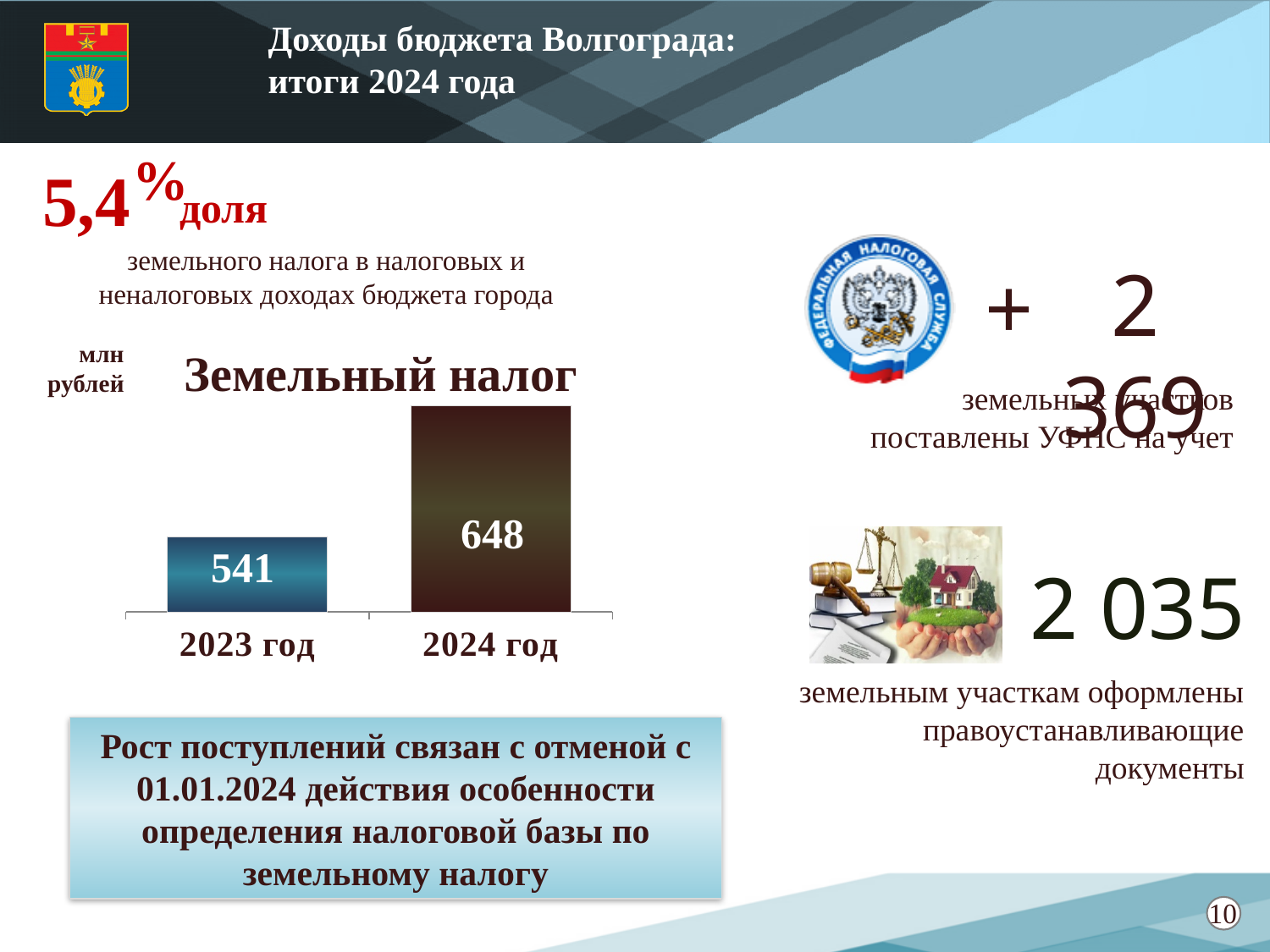
What unit is indicated for the values in the Земельный налог chart? млн рублей What is the value for 2024 год in the Земельный налог chart? 648 Which year has the highest value in the Земельный налог chart? 2024 год What is the title of the chart on the slide? Земельный налог What kind of chart is the Земельный налог chart? bar chart What is the difference between the 2024 год and 2023 год values in the Земельный налог chart? 107 What is the value for 2023 год in the Земельный налог chart? 541 Do the values in the Земельный налог chart rise or fall from 2023 год to 2024 год? rise In the Земельный налог chart, which is larger: the value for 2023 год or for 2024 год? 2024 год Which year has the lowest value in the Земельный налог chart? 2023 год How many bars are shown in the Земельный налог chart? 2